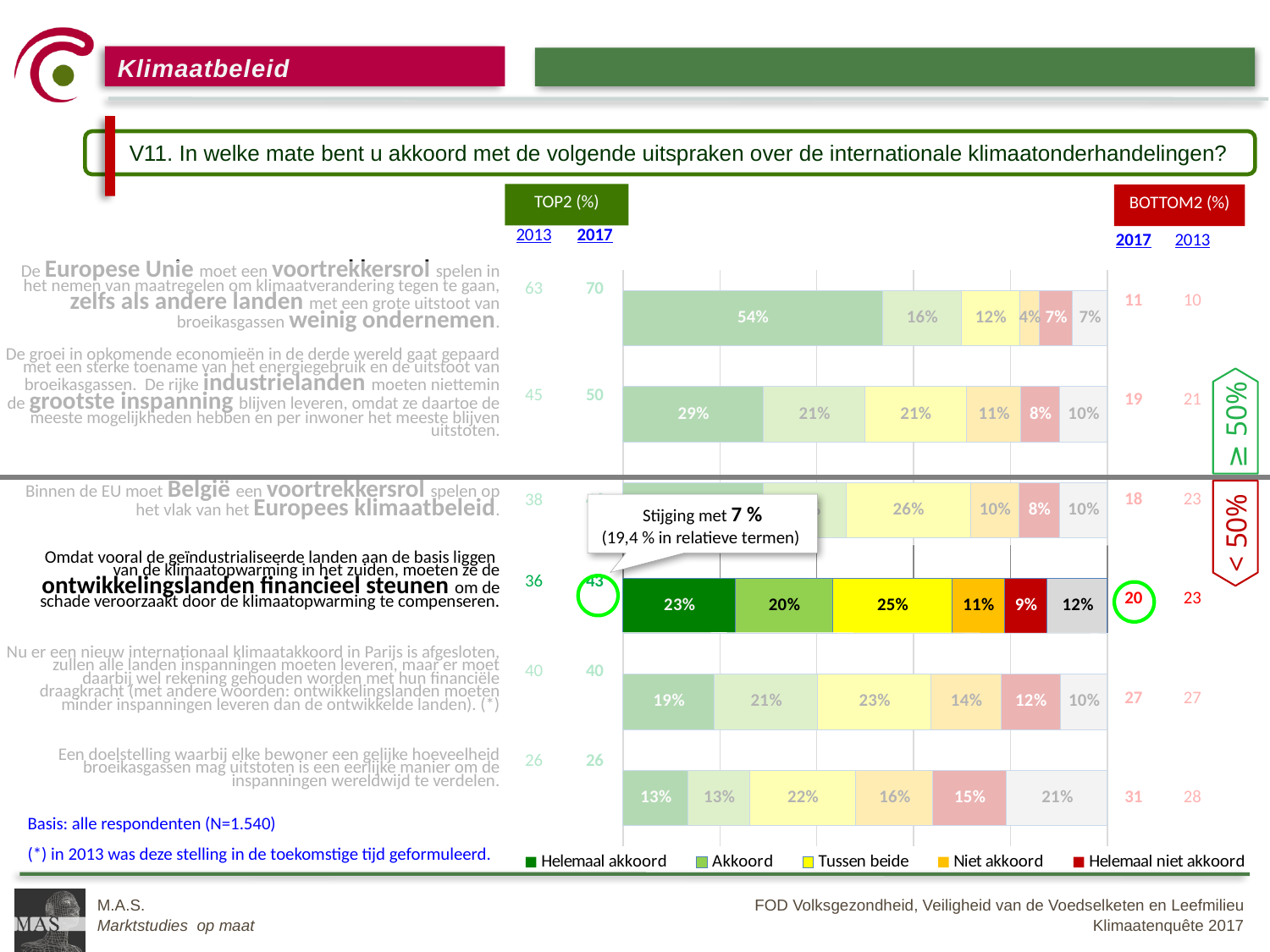
What is the TOP2 (%) value for 2017 for the statement that the European Union must play a leading role ('Europese Unie ... voortrekkersrol')? 70 How many series does the legend list? 5 What is the TOP2 (%) value for 2013 for the statement about financially supporting developing countries? 36 By how many points did the TOP2 score for the statement about financially supporting developing countries rise from 2013 to 2017? 7 What is the 'Tussen beide' percentage for the statement about financially supporting developing countries? 25% How many statements (bars) are plotted in the chart? 6 Which statement has the highest 'Helemaal akkoord' percentage? De Europese Unie moet een voortrekkersrol spelen (54%) Which is larger for the statement about financially supporting developing countries: the 'Akkoord' share or the 'Niet akkoord' share? Akkoord (20%) What kind of chart is shown on the slide? Stacked bar chart What is the 'Helemaal akkoord' percentage for the highlighted statement about financially supporting developing countries ('ontwikkelingslanden financieel steunen')? 23% What is the TOP2 (%) value for 2017 for the statement about financially supporting developing countries? 43 What is the BOTTOM2 (%) value for 2017 for the statement about financially supporting developing countries? 20